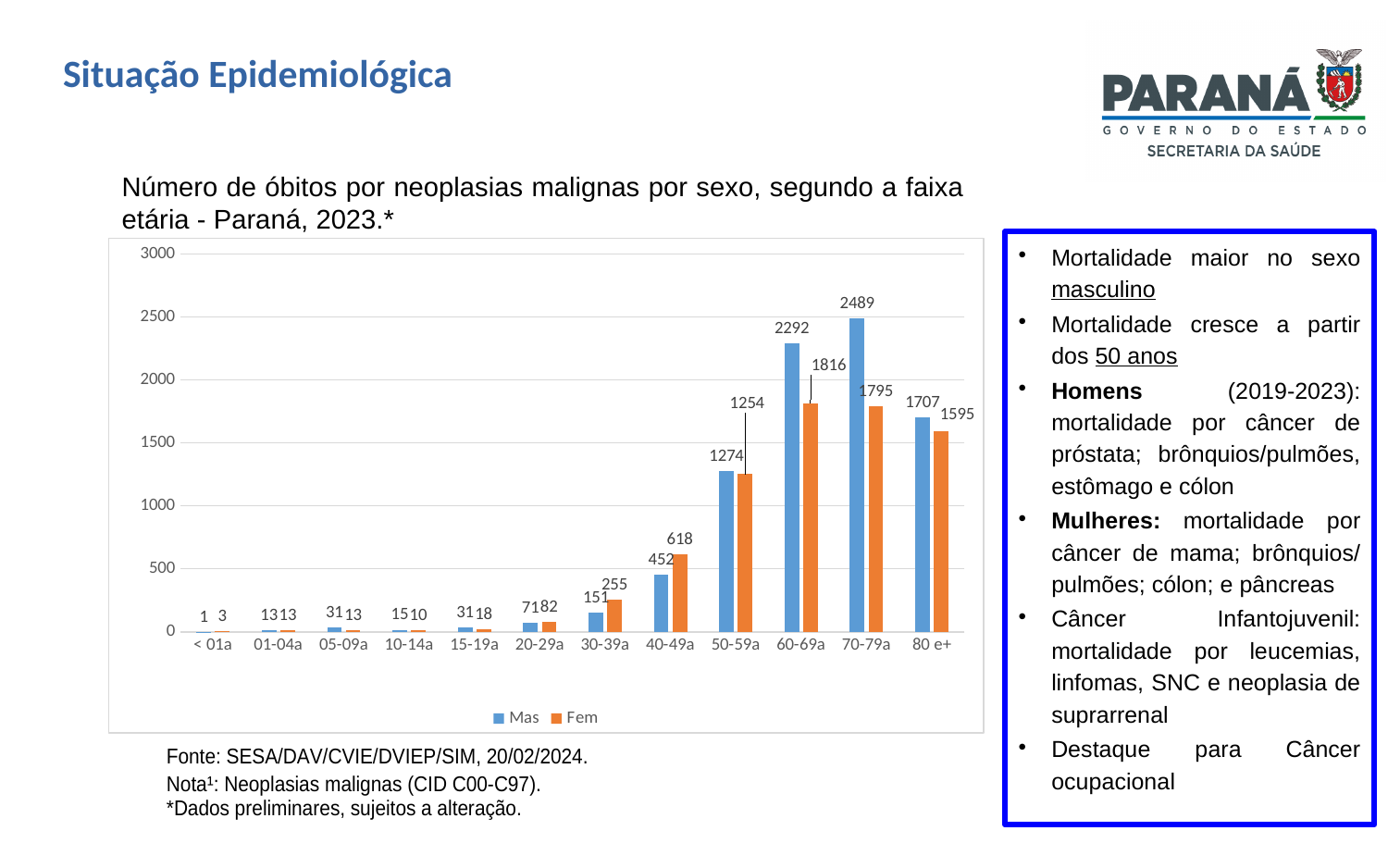
How many series does the legend list? 2 What is the value for Mas in the 70-79a age group? 2489 In the 40-49a age group, which series has the larger value, Mas or Fem? Fem What is the value for Fem in the 40-49a age group? 618 What is the difference between the Mas and Fem values in the 70-79a age group? 694 What is the value for Fem in the 60-69a age group? 1816 How many age groups are shown on the x axis? 12 What kind of chart is shown on the slide? Bar chart Which age group has the lowest value for the Mas series? < 01a Which age group has the highest value for the Fem series? 60-69a Is the Mas value for the 60-69a age group greater or less than 2000? greater Which age group has the highest value for the Mas series? 70-79a